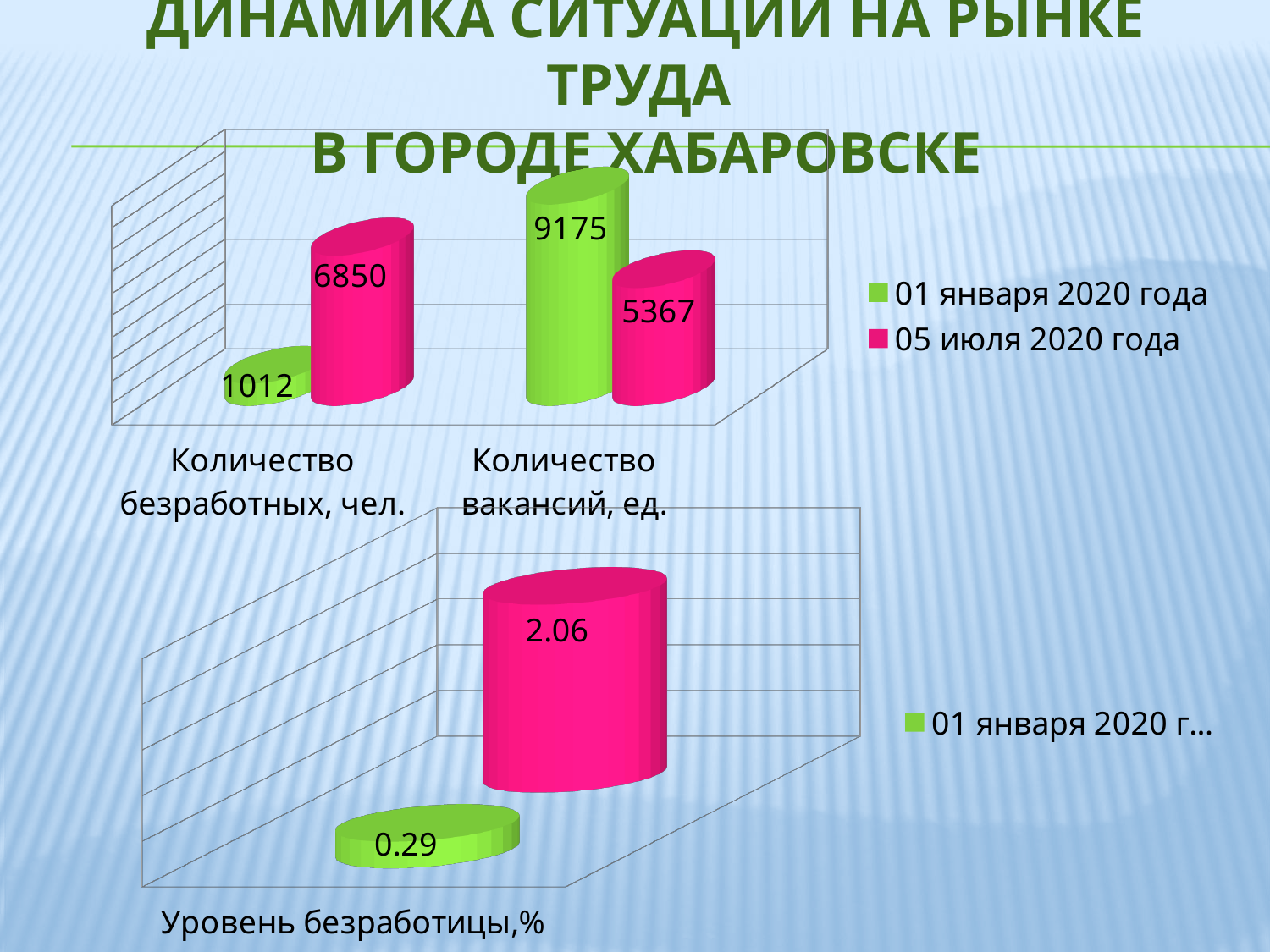
In the bottom chart, what is the value of the green bar for 'Уровень безработицы,%'? 0.29 In the top chart, what is the difference between the two values for 'Количество вакансий, ед.'? 3808 In the top chart, what is the value for 'Количество вакансий, ед.' for the series '01 января 2020 года'? 9175 In the top chart, how many series does the legend list? 2 What kind of chart is the bottom chart? bar chart In the top chart, what is the difference between the two values for 'Количество безработных, чел.'? 5838 In the top chart, how many categories are shown on the x axis? 2 In the bottom chart, what is the value of the pink bar for 'Уровень безработицы,%'? 2.06 In the top chart, what is the value for 'Количество безработных, чел.' for the series '05 июля 2020 года'? 6850 In the top chart, which series has the larger value for 'Количество безработных, чел.'? 05 июля 2020 года In the top chart, what is the value for 'Количество безработных, чел.' for the series '01 января 2020 года'? 1012 In the top chart, what is the value for 'Количество вакансий, ед.' for the series '05 июля 2020 года'? 5367